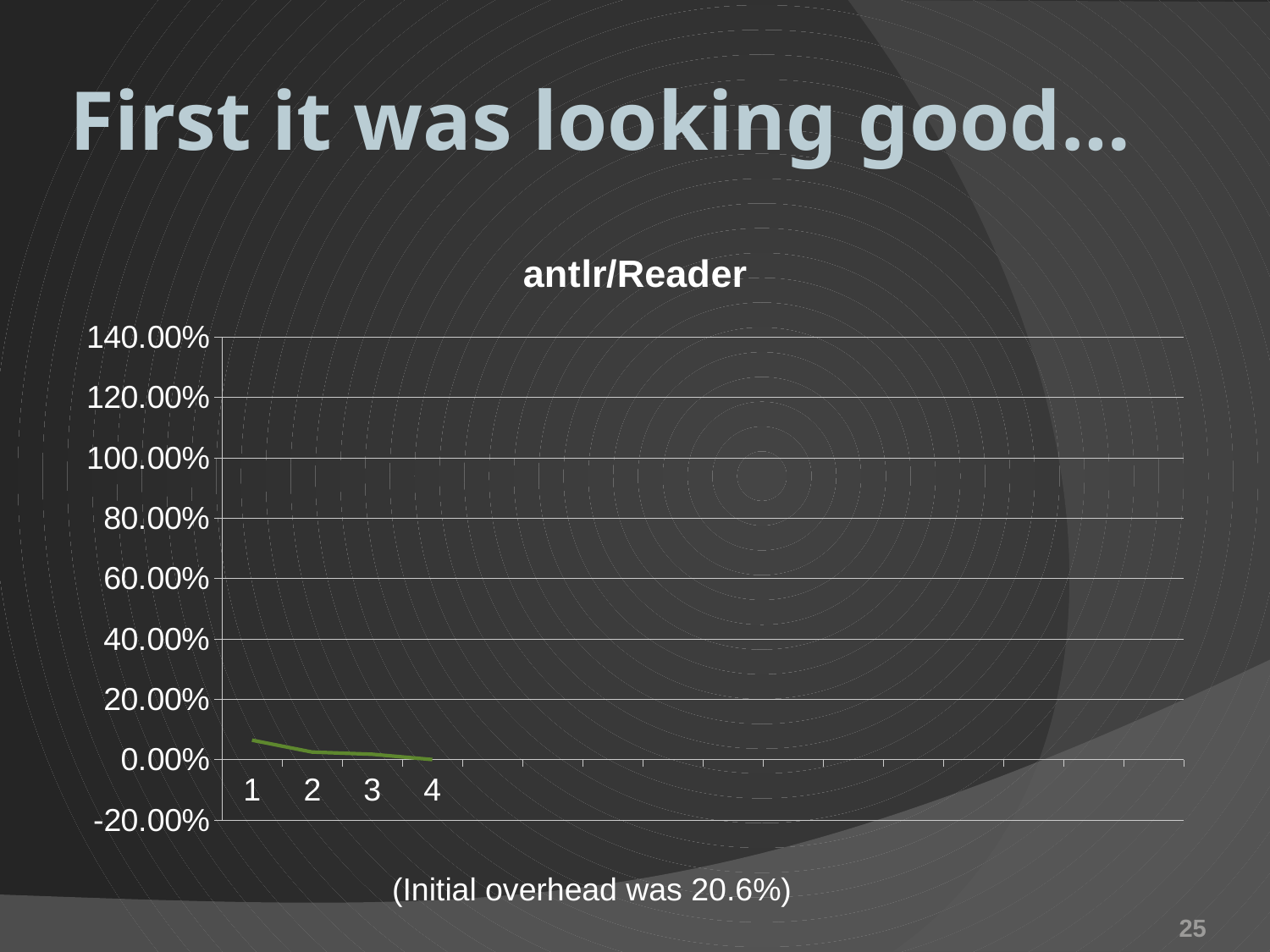
Is the value at point 2 greater or less than 20.00%? less Is the value at point 4 greater or less than 20.00%? less How many labeled points are shown on the x axis of the chart? 4 What kind of chart is shown on the slide? line chart Which x-axis point has the highest value in the chart? 1 What is the highest tick value shown on the y axis? 140.00% Which is larger, the value at point 1 or the value at point 4? point 1 Is the value at point 1 greater or less than 20.00%? less What is the title of the chart? antlr/Reader Do the values in the chart rise or fall from point 1 to point 4? fall